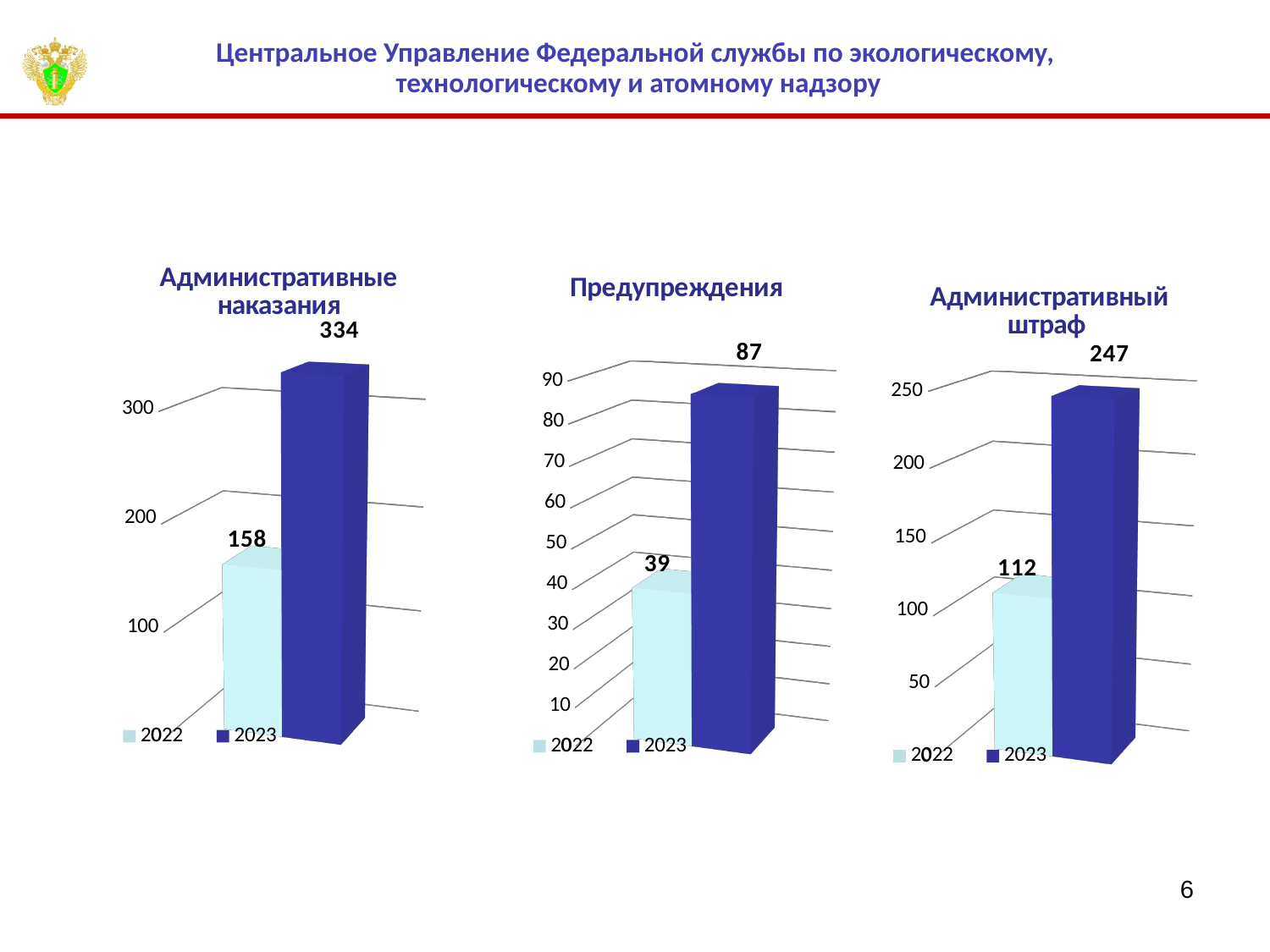
In the 'Предупреждения' chart, what is the value for 2023? 87 In the 'Предупреждения' chart, what is the difference between the 2023 and 2022 values? 48 In the 'Административные наказания' chart, what is the value for 2023? 334 In the 'Административные наказания' chart, what is the value for 2022? 158 In the 'Предупреждения' chart, how many series does the legend list? 2 What kind of chart is the 'Административный штраф' chart? Bar chart In the 'Предупреждения' chart, what is the value for 2022? 39 How many charts are shown on the slide? 3 In the 'Административный штраф' chart, what is the value for 2022? 112 In the 'Административный штраф' chart, what is the value for 2023? 247 In the 'Административные наказания' chart, what is the difference between the 2023 and 2022 values? 176 In the 'Административный штраф' chart, which year has the higher value, 2022 or 2023? 2023